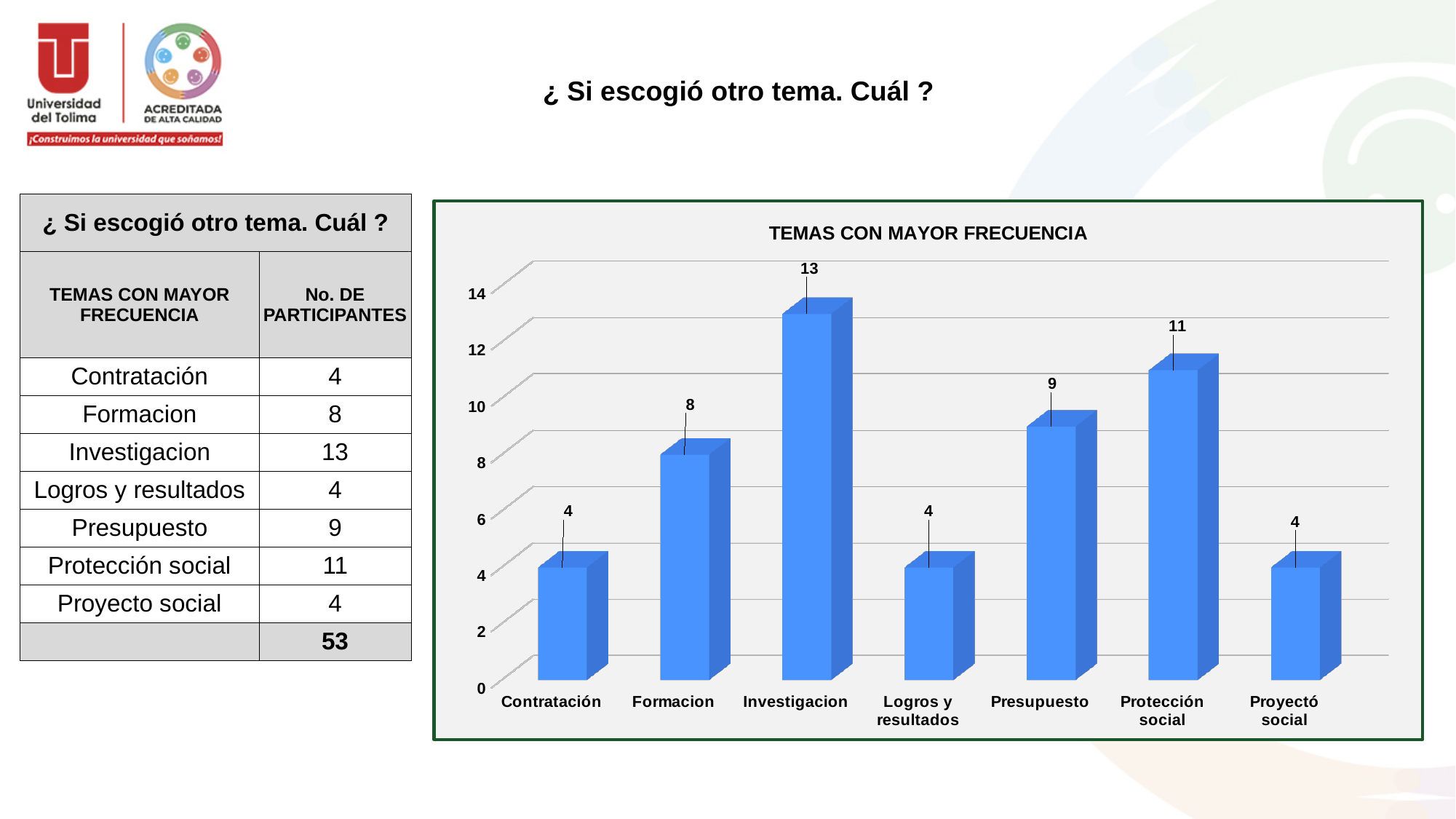
What kind of chart is shown? bar chart Which is larger, the value for Formacion or the value for Presupuesto? Presupuesto How many categories are shown on the x axis? 7 What is the title of the chart? TEMAS CON MAYOR FRECUENCIA What is the value for Investigacion? 13 What is the difference between the values for Presupuesto and Contratación? 5 How many categories have a value of 4? 3 What is the difference between the values for Investigacion and Protección social? 2 Is the value for Protección social greater or less than 10? greater Which category has the highest value? Investigacion What is the value for Presupuesto? 9 What is the value for Formacion? 8